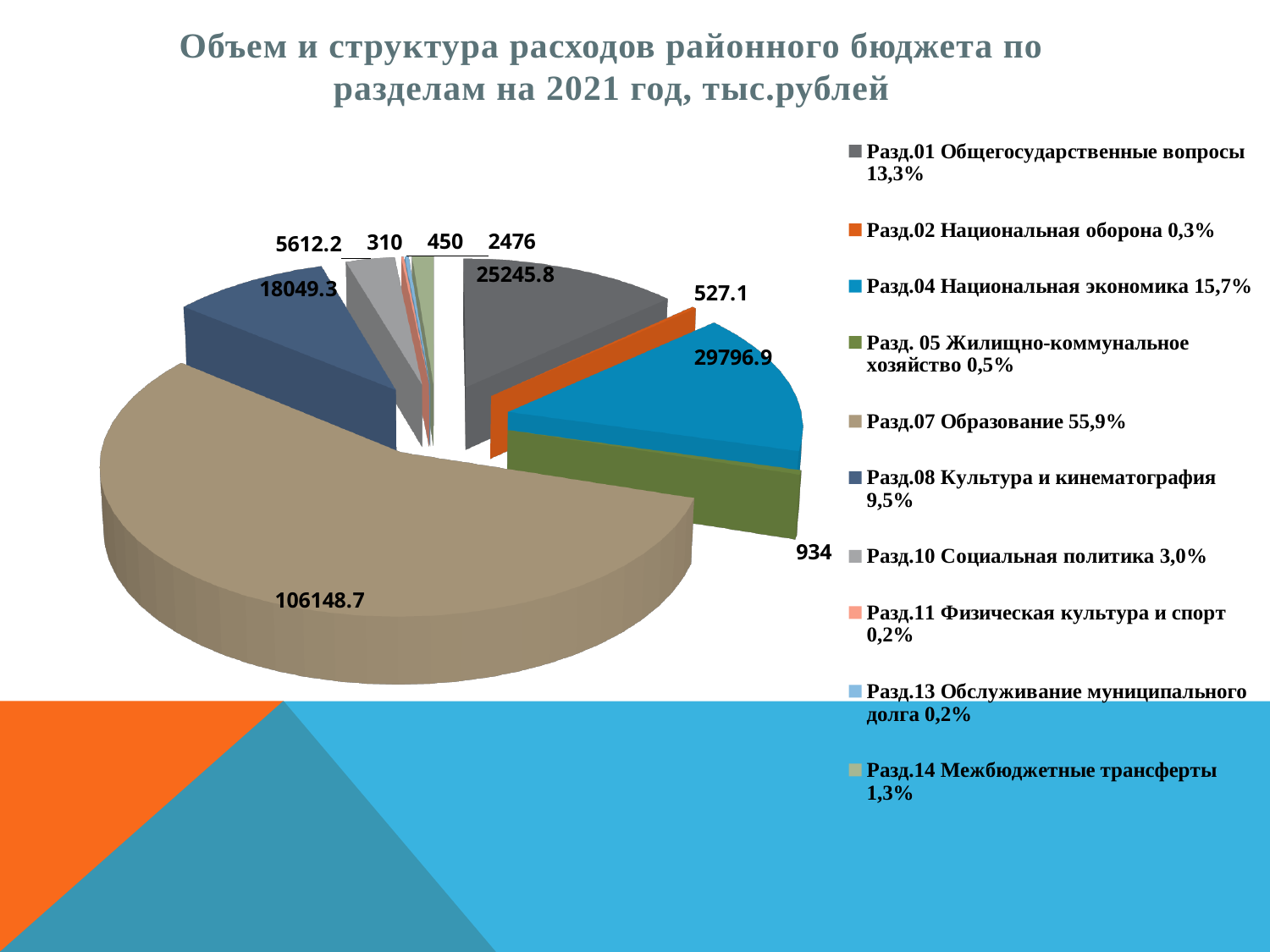
What kind of chart is shown on the slide? pie chart What is the difference between the values for Разд.04 Национальная экономика and Разд.01 Общегосударственные вопросы? 4551.1 What is the value for Разд.01 Общегосударственные вопросы? 25245.8 What is the value for Разд.08 Культура и кинематография? 18049.3 What is the value for Разд.04 Национальная экономика? 29796.9 What is the value for Разд.07 Образование? 106148.7 Which section has the largest share of the pie? Разд.07 Образование What share of the pie does Разд.04 Национальная экономика have? 15,7% What is the value for Разд.10 Социальная политика? 5612.2 What share of the pie does Разд.01 Общегосударственные вопросы have? 13,3% Which is larger, the value for Разд.04 Национальная экономика or Разд.01 Общегосударственные вопросы? Разд.04 Национальная экономика How many sections does the legend list? 10